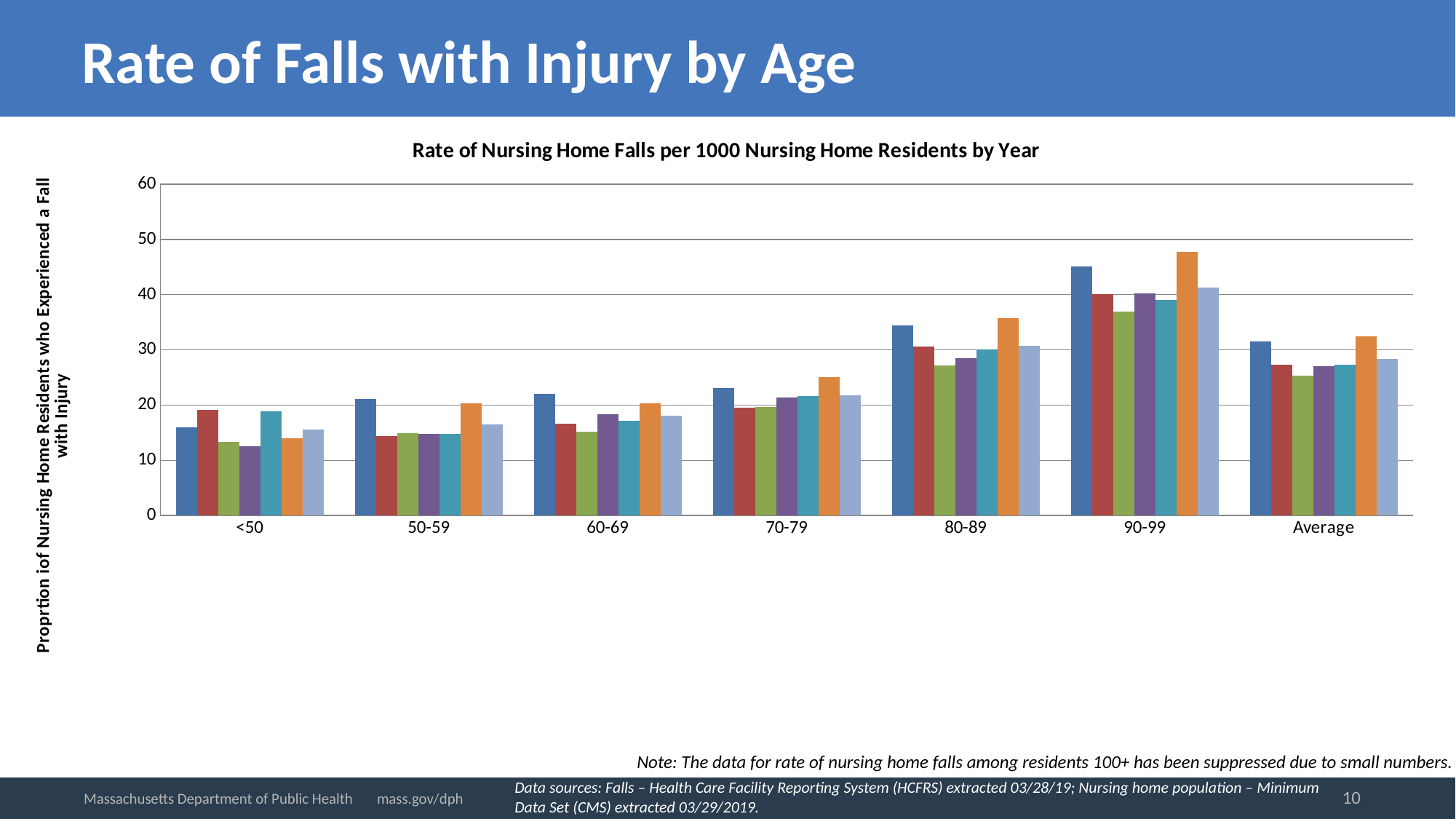
Is the value of the orange bar for the 90-99 age group greater or less than 40? greater What kind of chart is shown on the slide? bar chart What is the highest value shown on the y axis of the chart? 60 Is the value of the green bar for the <50 age group greater or less than 20? less Which is larger: the orange bar for the 90-99 age group or the orange bar for the 80-89 age group? 90-99 What is the title of the chart? Rate of Nursing Home Falls per 1000 Nursing Home Residents by Year Do the fall rates generally rise or fall as the age groups increase from <50 to 90-99? rise How many age-group categories are shown on the x axis of the chart? 6 How many bars are plotted for each age group in the chart? 7 Which age group has the lowest bars in the chart? <50 Is the value of the orange bar for the 80-89 age group greater or less than 30? greater Which age group has the highest bars in the chart? 90-99